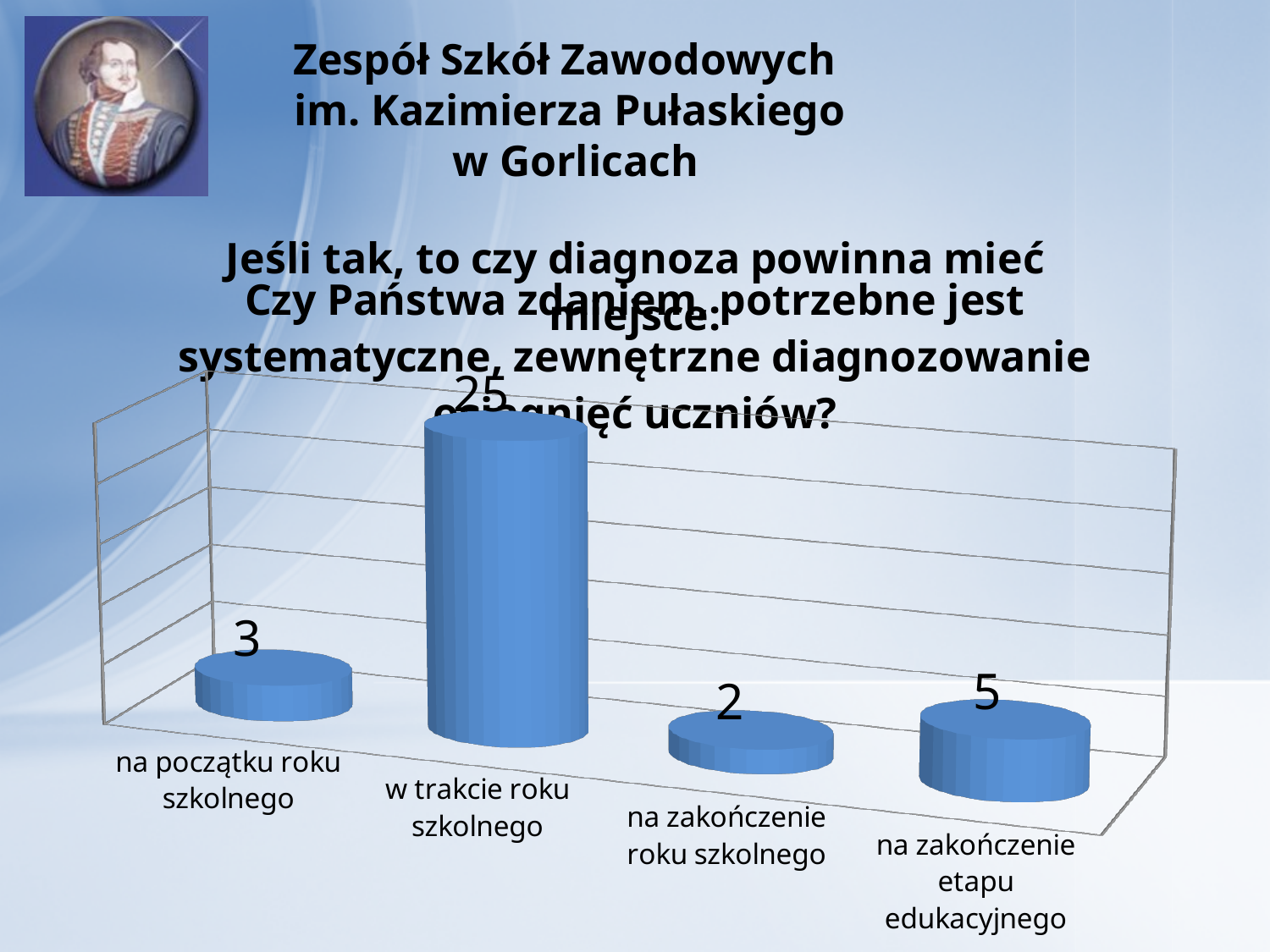
What colour are the bars in the chart? blue What is the difference between the values for "na zakończenie etapu edukacyjnego" and "na początku roku szkolnego"? 2 Which category has the lowest value? na zakończenie roku szkolnego Which category has the highest value? w trakcie roku szkolnego What is the difference between the values for "w trakcie roku szkolnego" and "na zakończenie etapu edukacyjnego"? 20 What kind of chart is shown on the slide? bar chart What is the value for "na zakończenie roku szkolnego"? 2 What is the value for "na zakończenie etapu edukacyjnego"? 5 What is the value for "w trakcie roku szkolnego"? 25 Which is larger: the value for "na początku roku szkolnego" or the value for "na zakończenie etapu edukacyjnego"? na zakończenie etapu edukacyjnego What is the value for "na początku roku szkolnego"? 3 How many categories are shown in the chart? 4